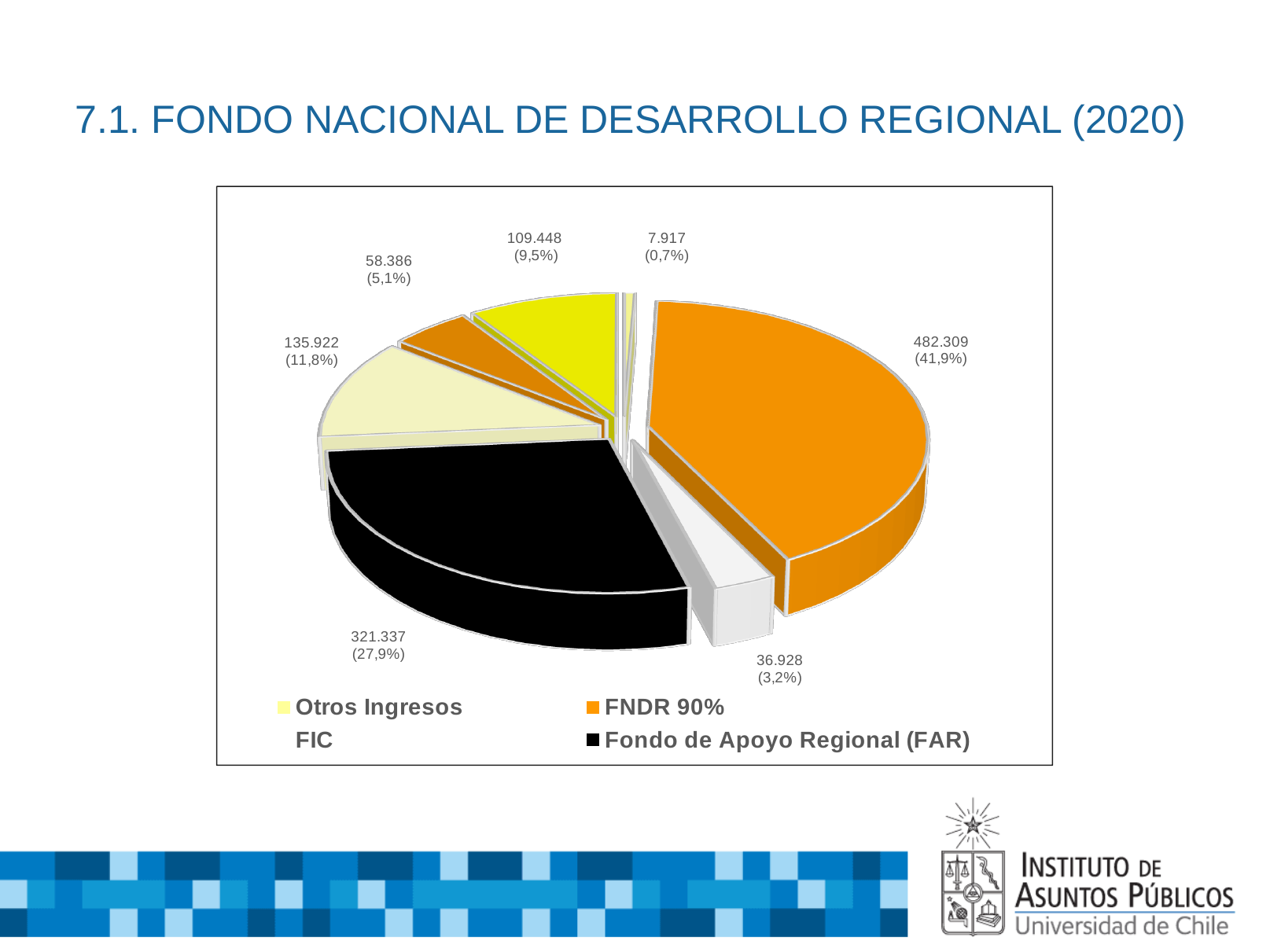
What share of the pie does FNDR 90% represent? 41,9% Which legend category has the largest slice of the pie? FNDR 90% How many entries does the legend list? 4 What share of the pie does Fondo de Apoyo Regional (FAR) represent? 27,9% Which is larger, the slice for FNDR 90% or the slice for Fondo de Apoyo Regional (FAR)? FNDR 90% How many slices does the pie chart have? 7 What is the value shown for FNDR 90%? 482.309 What share of the pie does Otros Ingresos represent? 0,7% What is the value of the smallest slice in the pie chart? 7.917 What is the value shown for Fondo de Apoyo Regional (FAR)? 321.337 What is the difference between the value for FNDR 90% and the value for Fondo de Apoyo Regional (FAR)? 160.972 What kind of chart is shown on the slide? pie chart